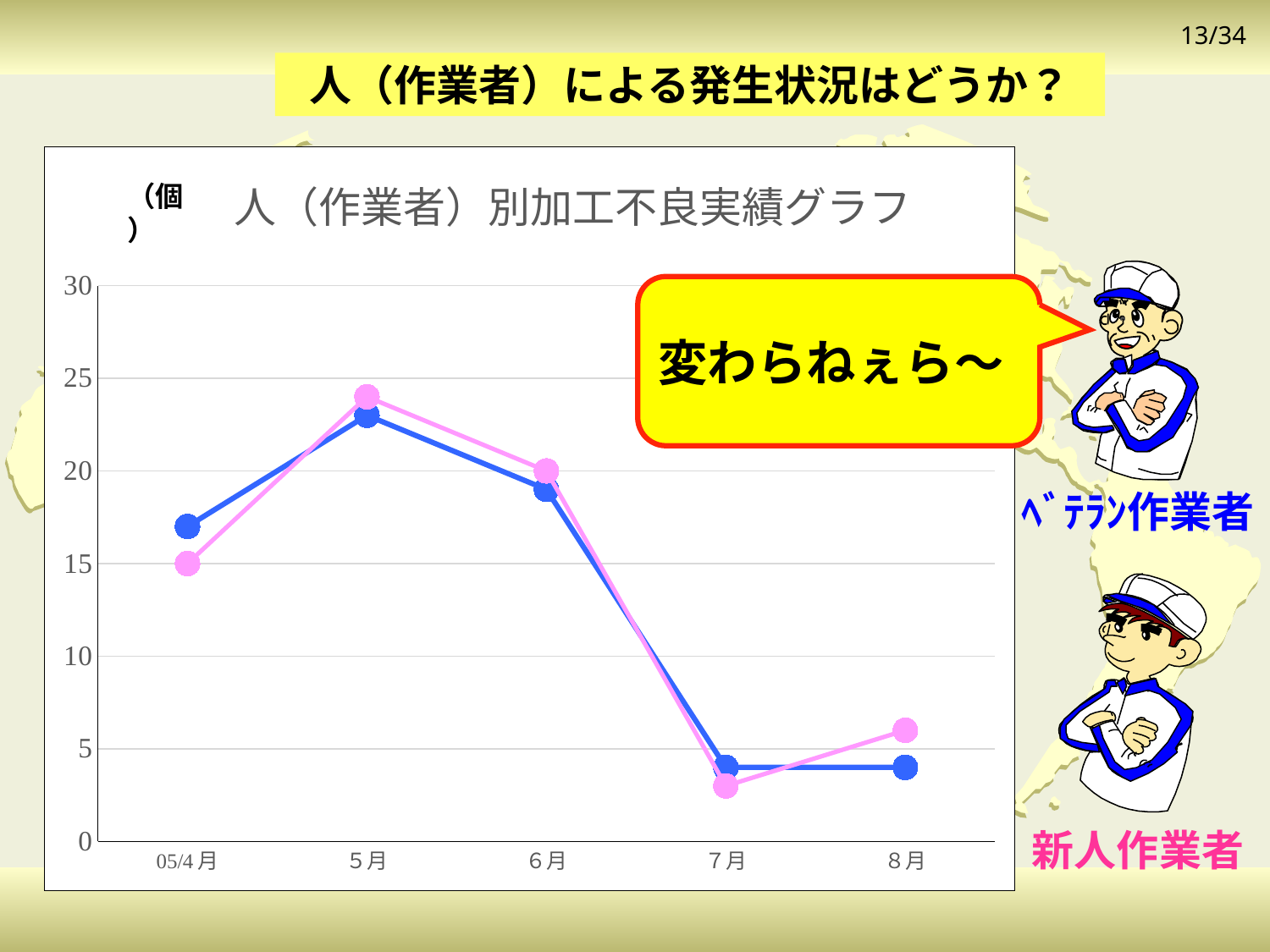
At 05/4月, which line has the higher value, the blue line (ベテラン作業者) or the pink line (新人作業者)? blue line (ベテラン作業者) How many lines (series) are plotted in the chart? 2 What kind of chart is shown on the slide? line chart Is the value of the blue line (ベテラン作業者) at 5月 greater or less than 20? greater What is the value of the pink line (新人作業者) at 05/4月? 15 What is the title of the chart? 人（作業者）別加工不良実績グラフ In which month does the pink line (新人作業者) reach its lowest value? 7月 In which month does the blue line (ベテラン作業者) reach its highest value? 5月 In which month does the pink line (新人作業者) reach its highest value? 5月 How many months are plotted along the x axis of the chart? 5 What is the value of the pink line (新人作業者) at 6月? 20 Is the value of the blue line (ベテラン作業者) at 7月 greater or less than 5? less